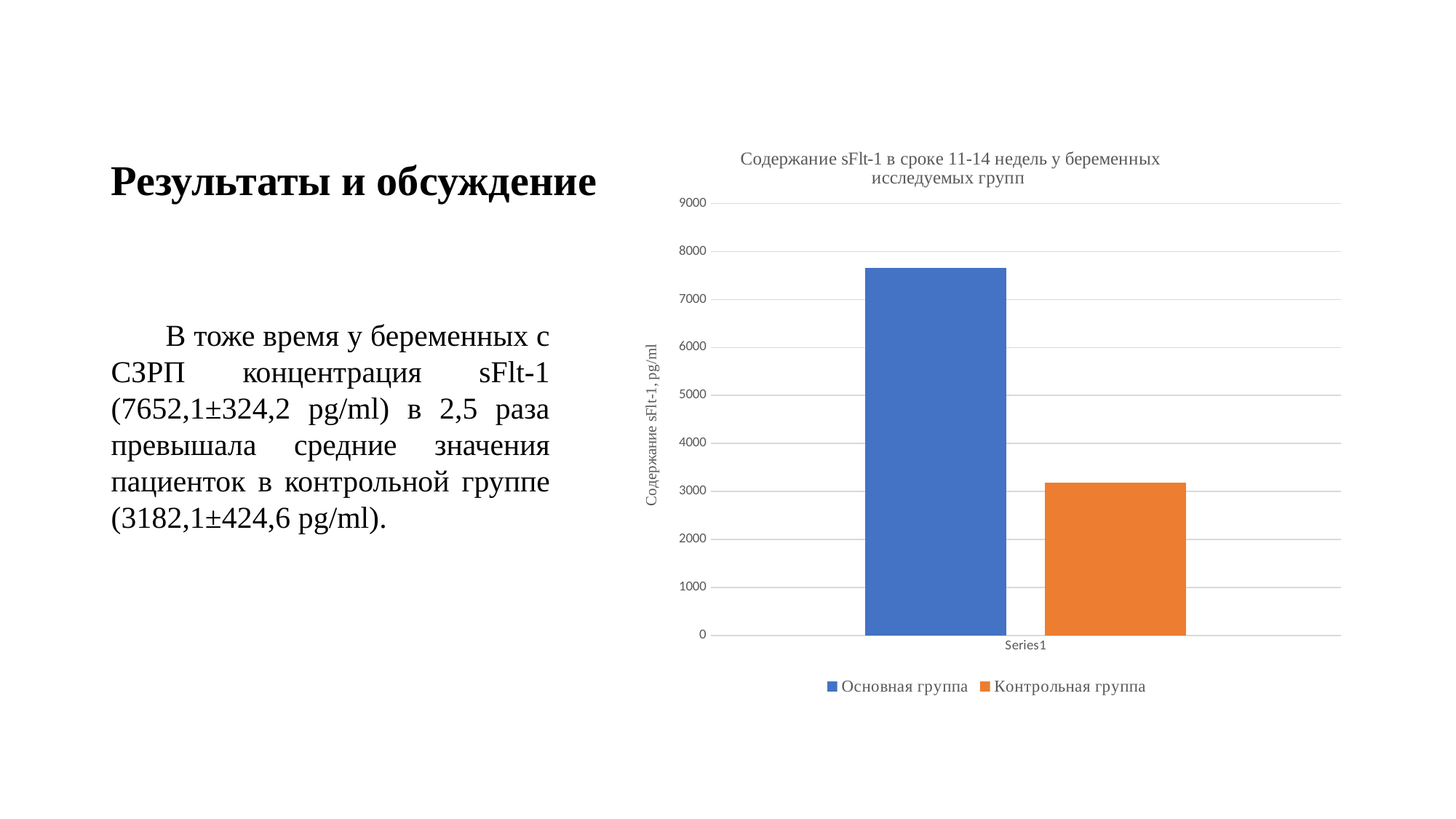
How many series does the chart legend list? 2 Which series has the tallest bar in the chart? Основная группа How many categories are shown on the x axis of the chart? 1 Which series has the higher bar, Основная группа or Контрольная группа? Основная группа Is the value for Контрольная группа greater or less than 3000? greater Is the value for Основная группа greater or less than 8000? less What kind of chart is shown on the slide? bar chart Is the value for Контрольная группа greater or less than 4000? less What colour is the bar for Контрольная группа? orange What is the title of the chart? Содержание sFlt-1 в сроке 11-14 недель у беременных исследуемых групп Which series has the shortest bar in the chart? Контрольная группа